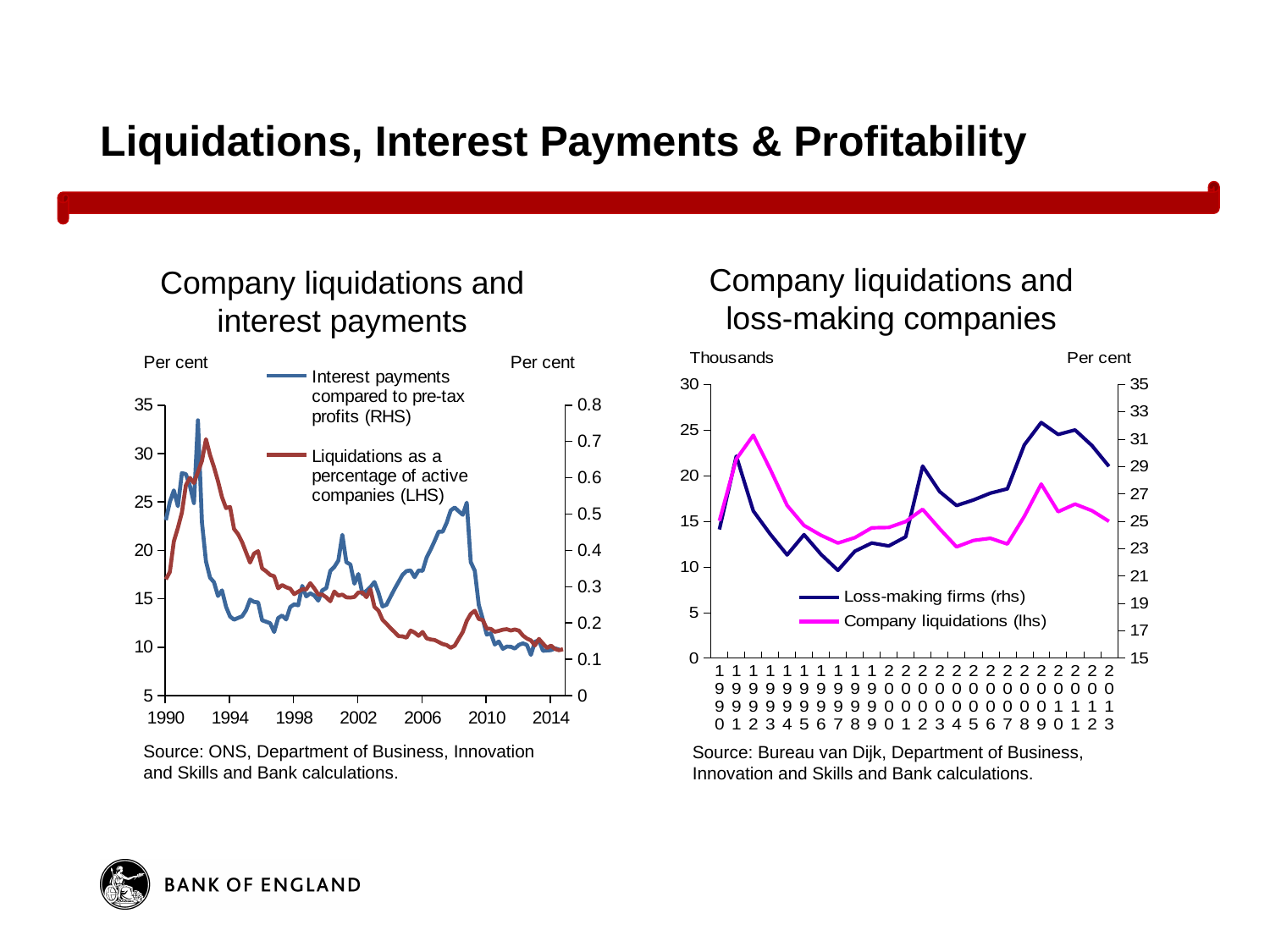
In the 'Company liquidations and loss-making companies' chart, does the Company liquidations (lhs) series rise or fall from 2010 to 2013? Fall In the 'Company liquidations and loss-making companies' chart, is the value for Company liquidations (lhs) in 1992 greater or less than 20? greater In the 'Company liquidations and loss-making companies' chart, which series is plotted on the left-hand axis? Company liquidations (lhs) What kind of chart is the 'Company liquidations and loss-making companies' chart? Line chart How many series does the legend of the 'Company liquidations and loss-making companies' chart list? 2 In the 'Company liquidations and loss-making companies' chart, which year has the higher value for Company liquidations (lhs): 1992 or 2007? 1992 How many series does the legend of the 'Company liquidations and interest payments' chart list? 2 In the 'Company liquidations and loss-making companies' chart, is the value for Loss-making firms (rhs) in 2010 greater or less than 30? greater In the 'Company liquidations and loss-making companies' chart, is the value for Company liquidations (lhs) in 2007 greater or less than 15? less What kind of chart is the 'Company liquidations and interest payments' chart? Line chart In the 'Company liquidations and loss-making companies' chart, how many years are shown on the x axis? 24 In the 'Company liquidations and interest payments' chart, what is the unit shown on the left-hand axis? Per cent